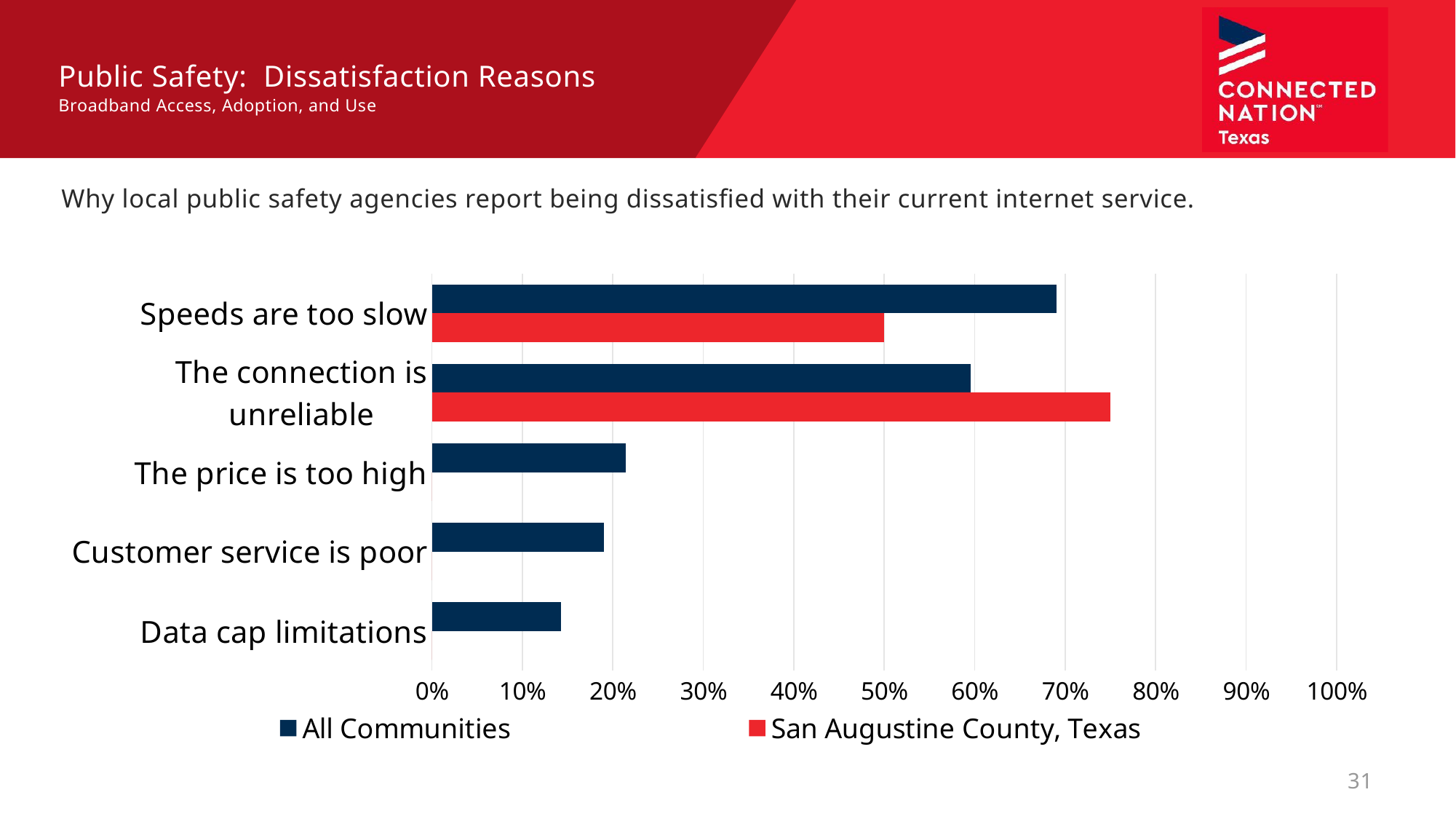
How many dissatisfaction reasons (categories) are shown on the chart? 5 How many series does the legend list? 2 Is the All Communities value for "Data cap limitations" greater or less than 20%? less What kind of chart is shown on the slide? bar chart For "The connection is unreliable", which series has the larger value? San Augustine County, Texas For "Speeds are too slow", which series has the larger value? All Communities For the All Communities series, which reason has the highest value? Speeds are too slow What are the two series named in the legend? All Communities; San Augustine County, Texas Is the All Communities value for "Speeds are too slow" greater or less than 60%? greater Is the San Augustine County, Texas value for "The connection is unreliable" greater or less than 70%? greater For the All Communities series, which reason has the lowest value? Data cap limitations